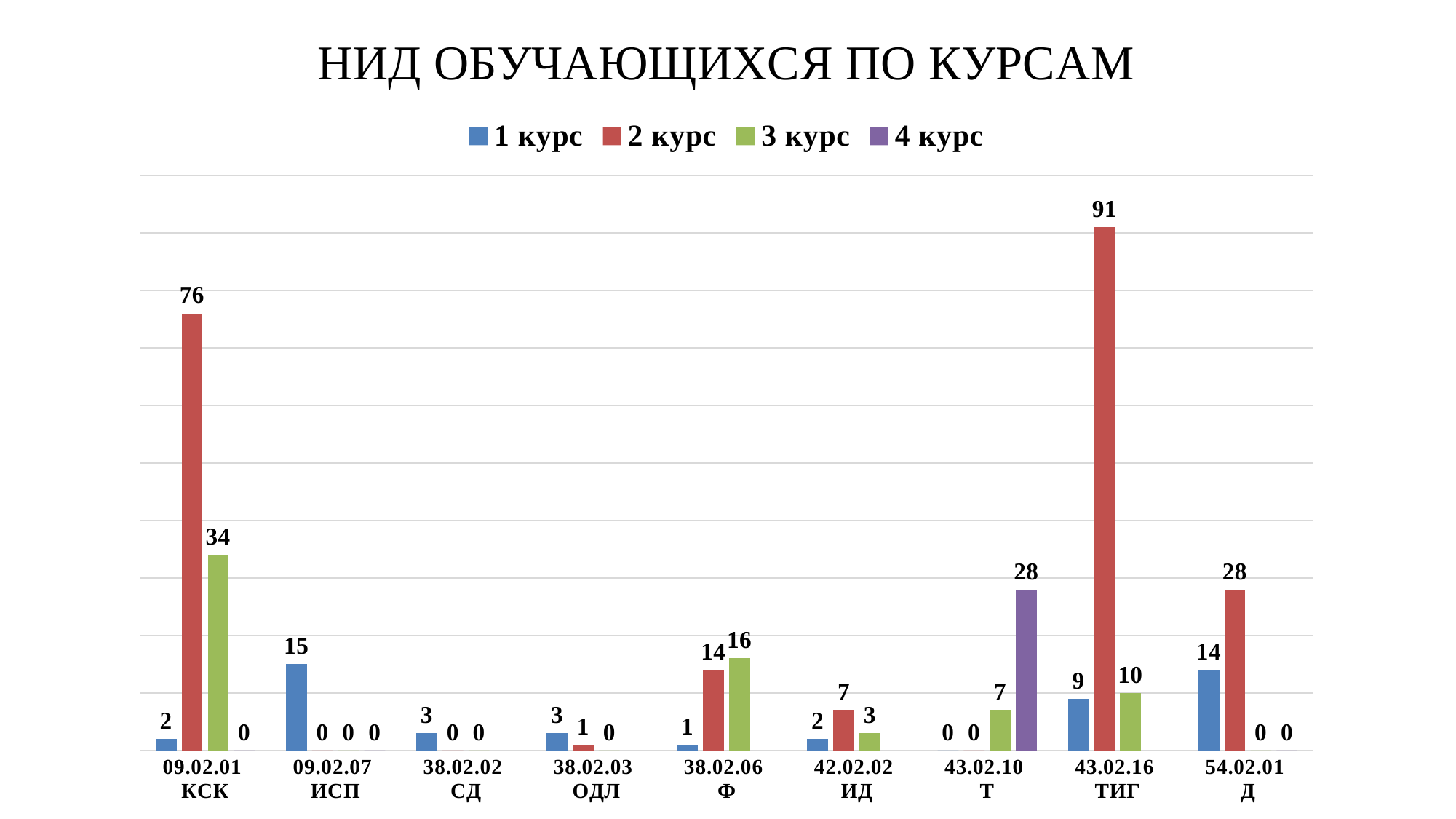
What is the value for 4 курс in category 43.02.10 Т? 28 Which category has the highest value for 1 курс? 09.02.07 ИСП What is the value for 1 курс in category 09.02.07 ИСП? 15 What is the difference between the 2 курс values for 43.02.16 ТИГ and 09.02.01 КСК? 15 How many categories are shown on the x axis? 9 How many series does the legend list? 4 What is the value for 3 курс in category 09.02.01 КСК? 34 Which is larger in category 38.02.06 Ф: the value for 2 курс or for 3 курс? 3 курс Which category has the highest value for 2 курс? 43.02.16 ТИГ What is the value for 2 курс in category 09.02.01 КСК? 76 What kind of chart is shown on the slide? Bar chart What is the value for 2 курс in category 43.02.16 ТИГ? 91